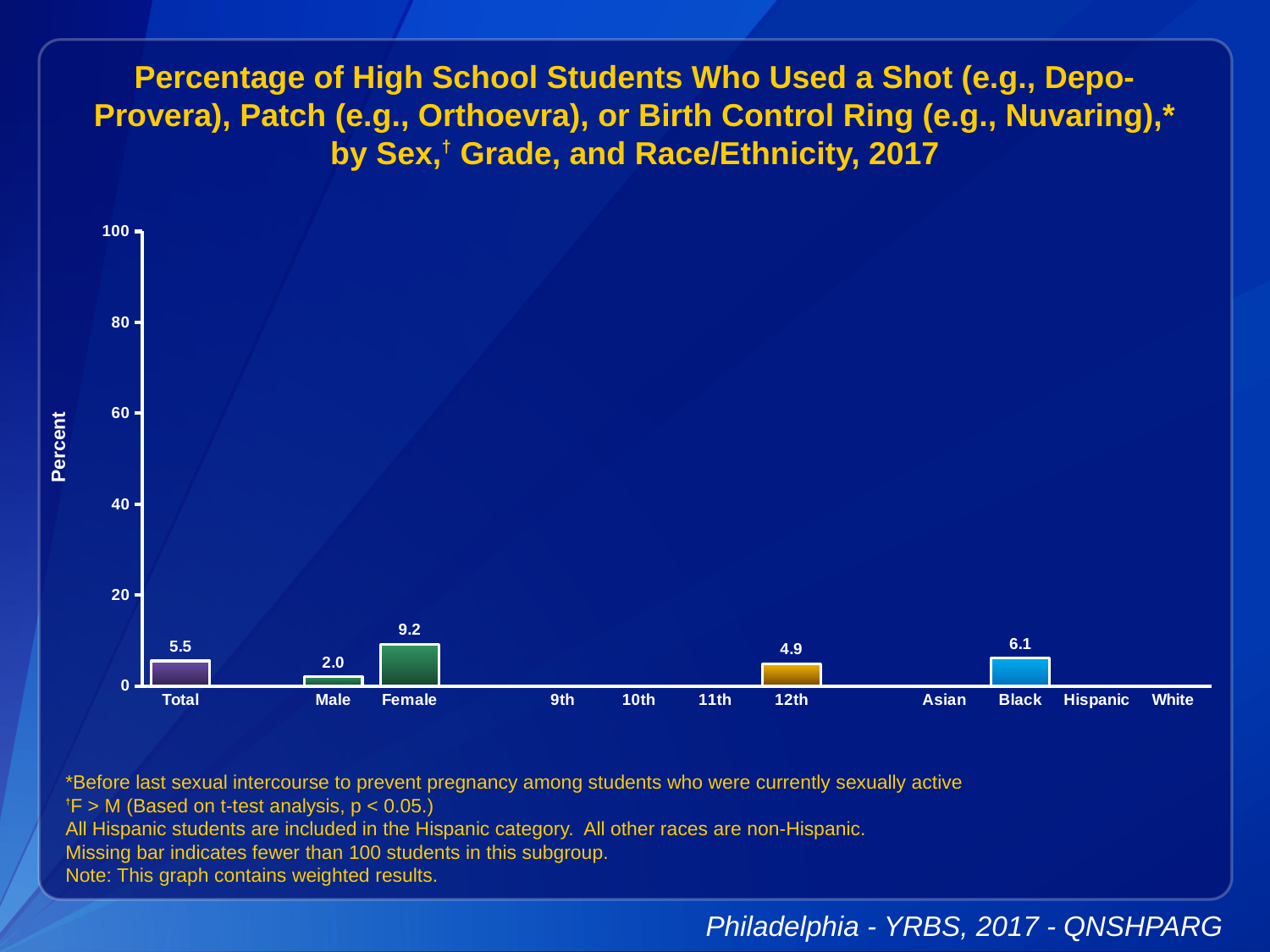
What is the value for Male? 2.0 What is the value for Total? 5.5 What is the value for Female? 9.2 What is the value for Black students? 6.1 Is the value for Female greater or less than 20? less What is the difference between the Female and Male values? 7.2 Which category has the lowest value among the plotted bars? Male What type of chart is shown on the slide? bar chart Which category has the highest value among the plotted bars? Female How many category labels are shown on the x axis? 11 Which is larger, the value for Black or the value for 12th grade? Black What is the value for 12th grade? 4.9